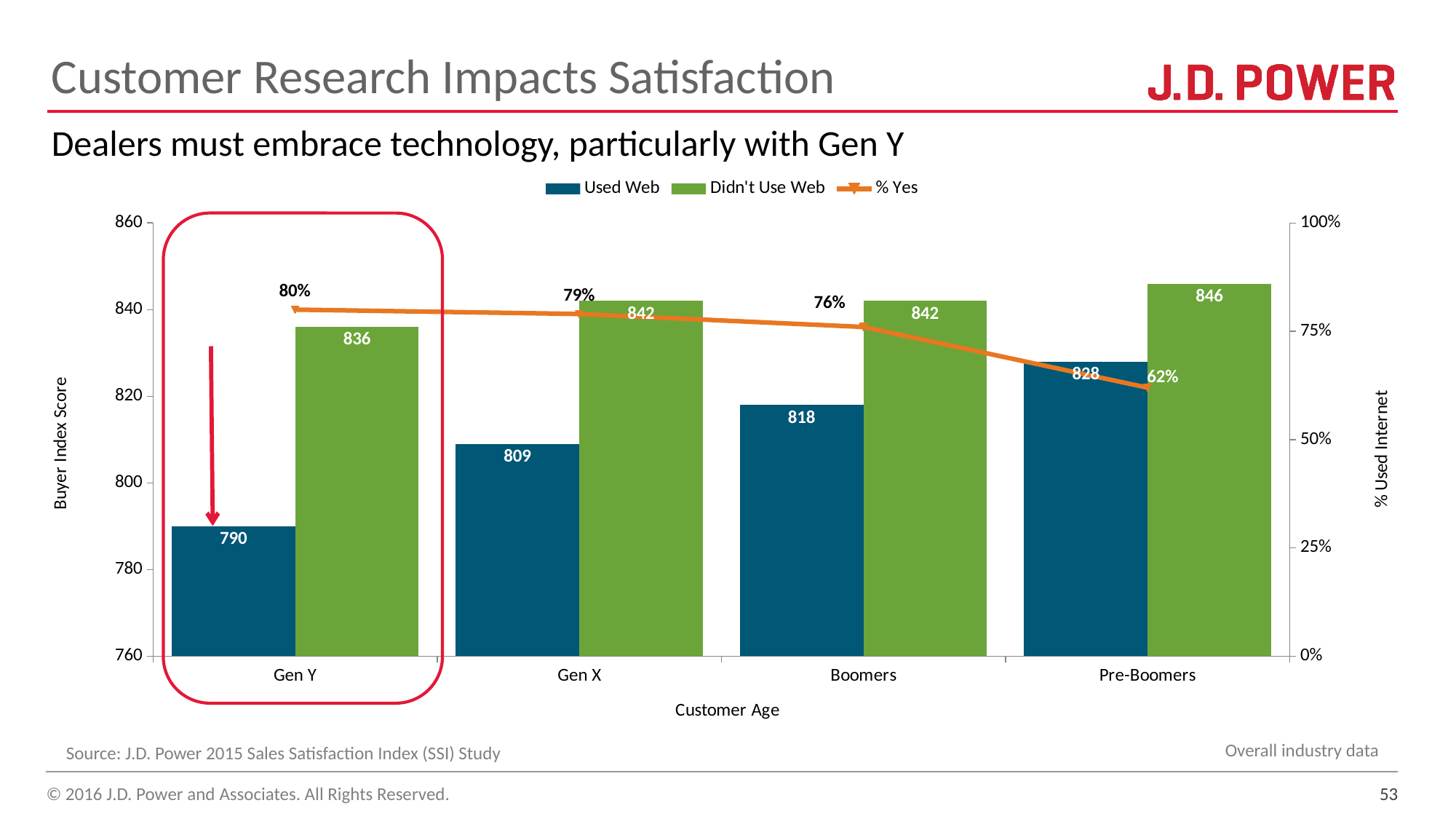
How many customer age groups are shown on the x axis? 4 How many series does the legend list? 3 Does the % Yes line rise or fall from Gen Y to Pre-Boomers? Fall What is the difference between the Didn't Use Web and Used Web scores for Gen Y? 46 Which is larger for Gen X: the Used Web score or the Didn't Use Web score? Didn't Use Web What is the Buyer Index Score for Gen Y buyers who used the web? 790 What is the label of the right-hand vertical axis? % Used Internet What is the Buyer Index Score for Pre-Boomers who didn't use the web? 846 Which customer age group has the highest Buyer Index Score among those who didn't use the web? Pre-Boomers What percentage of Boomers used the internet (% Yes)? 76% Which customer age group has the lowest Buyer Index Score among those who used the web? Gen Y What kind of chart is used to show the Used Web and Didn't Use Web scores? Bar chart